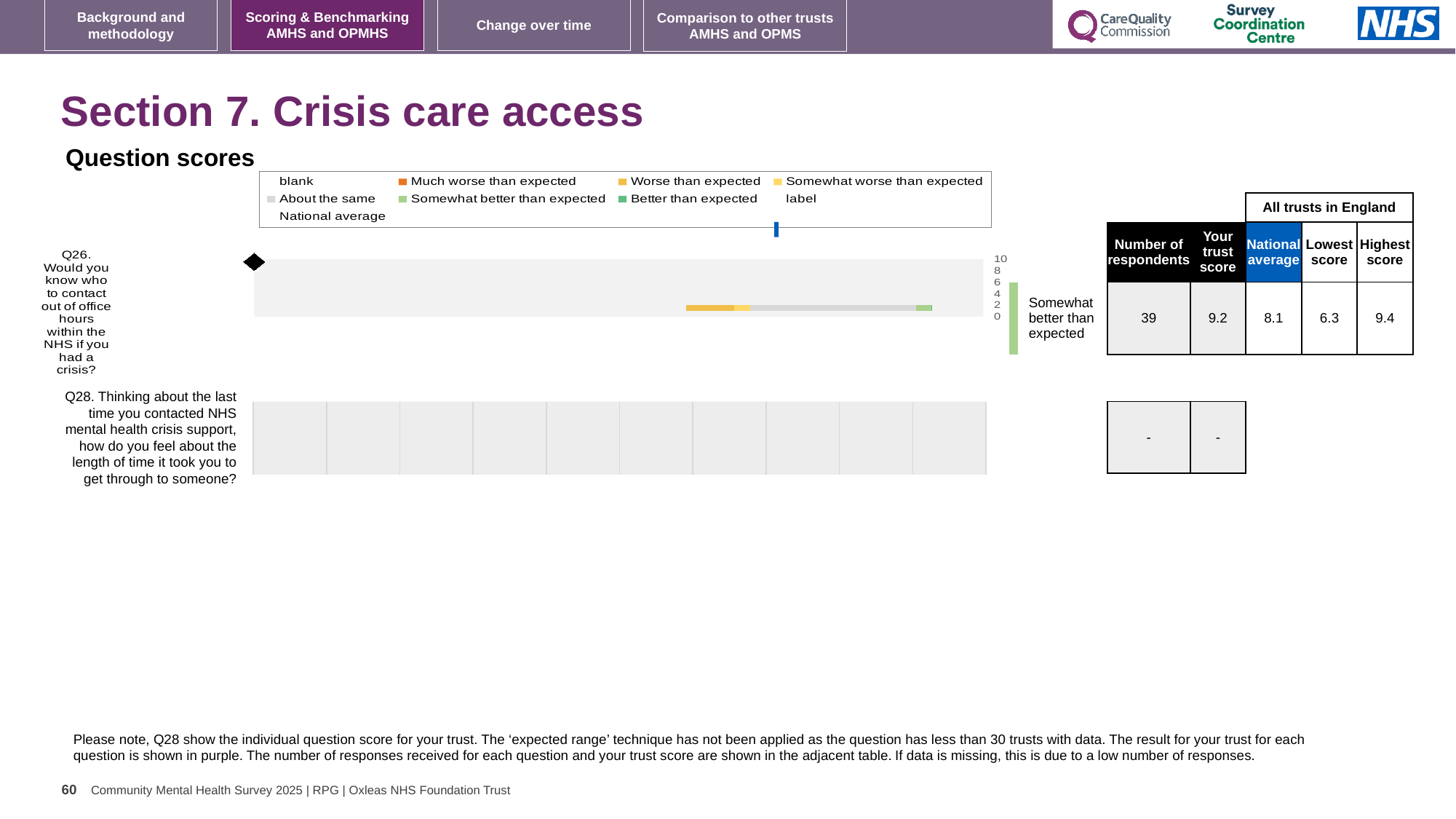
What is the lowest score among all trusts in England for Q26? 6.3 How many respondents answered Q26? 39 What is the national average score for Q26? 8.1 How many questions are plotted in the Question scores chart? 2 What is the difference between the trust score and the national average for Q26? 1.1 What is the maximum value shown on the score axis of the chart? 10 Which is larger for Q26, the trust score or the national average? Trust score What kind of chart is used to show the question scores? Bar chart What is the highest score among all trusts in England for Q26? 9.4 What is the trust score for Q26 (Would you know who to contact out of office hours within the NHS if you had a crisis?)? 9.2 How is the trust's Q26 result categorised relative to the expected range? Somewhat better than expected What is the difference between the highest and lowest scores among all trusts in England for Q26? 3.1